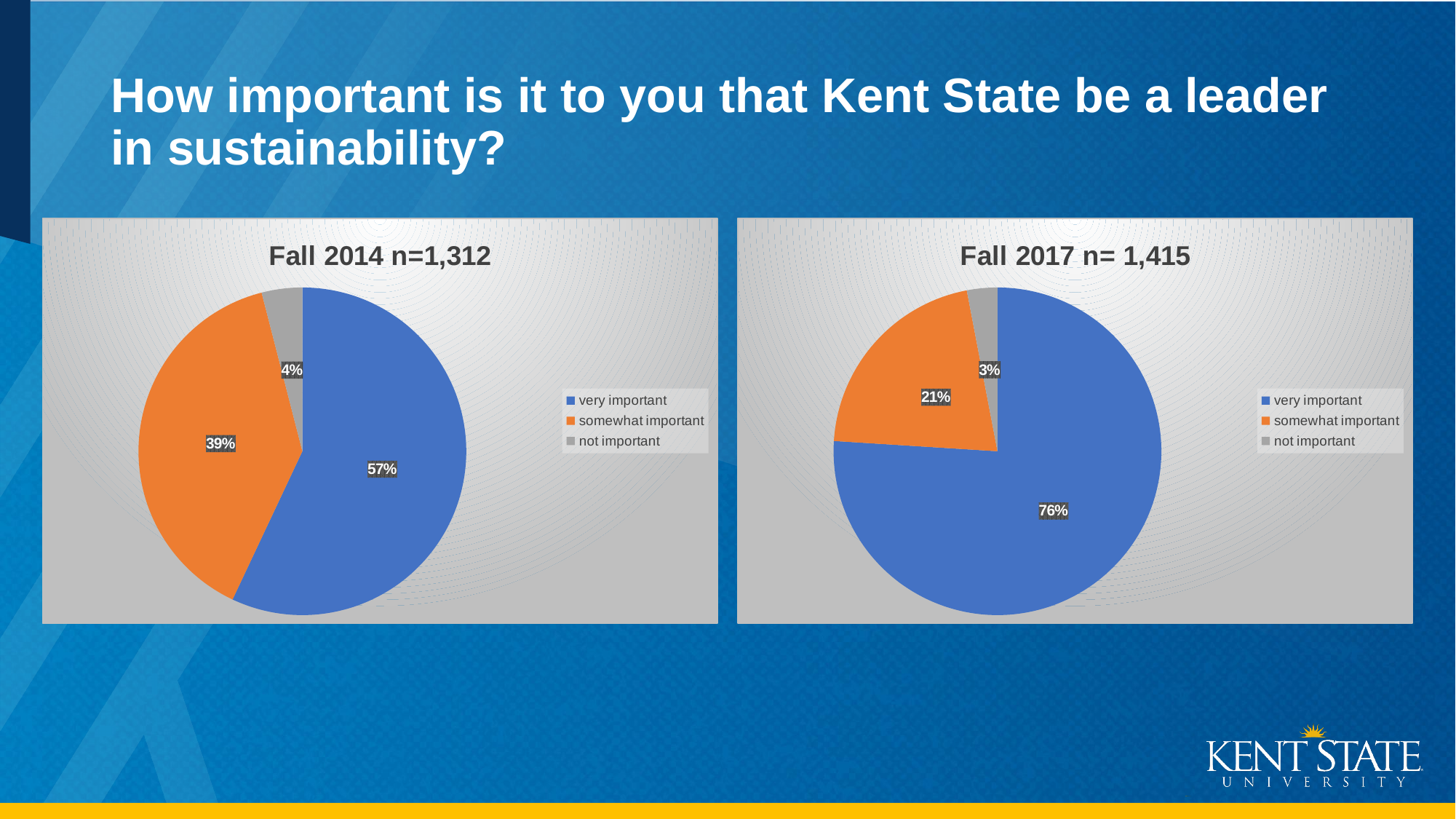
In the Fall 2017 n= 1,415 chart, what colour represents 'not important'? gray What is the difference between the 'very important' share in the Fall 2017 n= 1,415 chart and the 'very important' share in the Fall 2014 n=1,312 chart? 19% Which chart shows a larger share for 'somewhat important', Fall 2014 n=1,312 or Fall 2017 n= 1,415? Fall 2014 n=1,312 In the Fall 2014 n=1,312 chart, what percentage of respondents said 'very important'? 57% In the Fall 2014 n=1,312 chart, what is the difference between the 'very important' and 'somewhat important' shares? 18% What is the title of the chart on the right side of the slide? Fall 2017 n= 1,415 In the Fall 2014 n=1,312 chart, what percentage of respondents said 'not important'? 4% In the Fall 2014 n=1,312 chart, which category has the smallest share? not important In the Fall 2017 n= 1,415 chart, which category has the largest share? very important How many categories are shown in the Fall 2017 n= 1,415 chart? 3 In the Fall 2017 n= 1,415 chart, what percentage of respondents said 'somewhat important'? 21% What type of chart is the Fall 2014 n=1,312 chart? pie chart